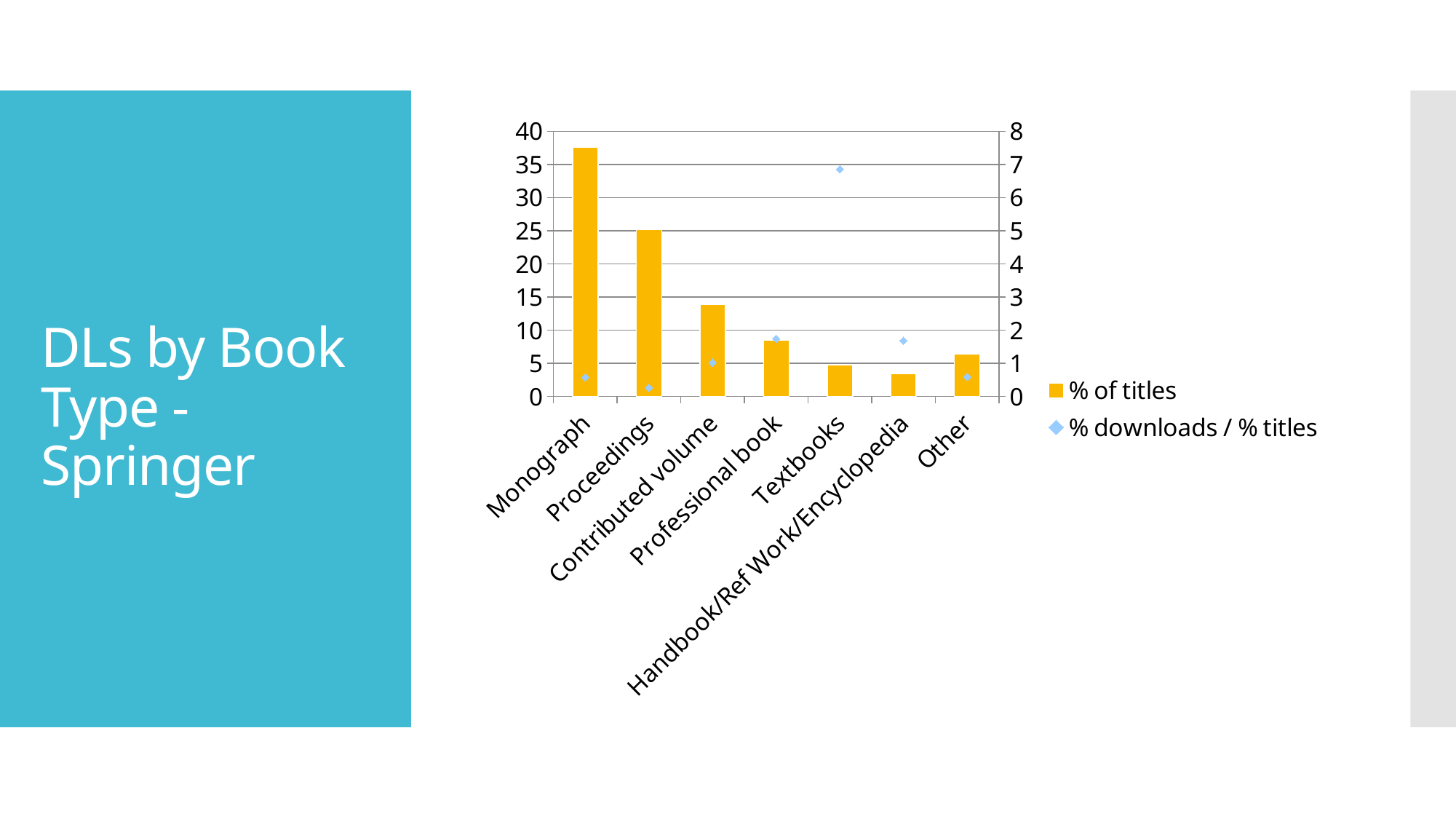
Which has a larger % of titles value, Proceedings or Contributed volume? Proceedings Which category has the lowest value for % of titles? Handbook/Ref Work/Encyclopedia Is the % downloads / % titles value for Textbooks greater or less than 6? greater Is the % of titles value for Monograph greater or less than 35? greater Which category has the highest value for % downloads / % titles? Textbooks How many series does the legend list? 2 Which category has the highest value for % of titles? Monograph What colour are the bars for the % of titles series? Orange How many book type categories are shown on the x axis? 7 Is the % of titles value for Contributed volume greater or less than 15? less Do the % of titles values rise or fall from Monograph to Handbook/Ref Work/Encyclopedia? fall